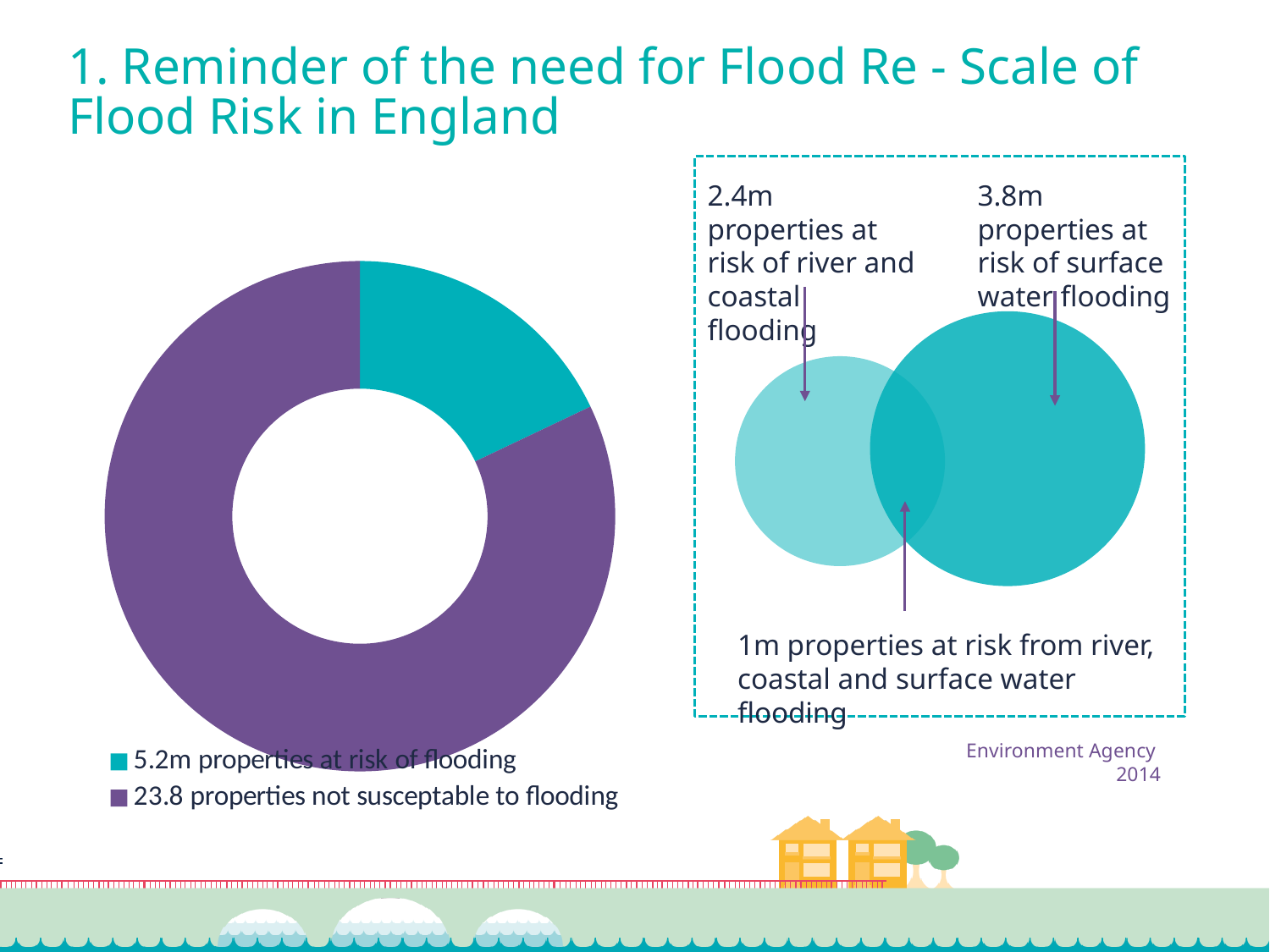
Which category takes the smaller share of the doughnut chart? 5.2m properties at risk of flooding In the overlapping-circles diagram on the right, how many properties are at risk of river and coastal flooding? 2.4m What kind of chart is shown on the left of the slide? doughnut chart In the doughnut chart, which colour represents properties not susceptable to flooding? purple In the overlapping-circles diagram on the right, how many properties are at risk of surface water flooding? 3.8m In the overlapping-circles diagram on the right, how many properties are at risk from river, coastal and surface water flooding? 1m In the doughnut chart, what value is given for properties not susceptable to flooding? 23.8 In the doughnut chart, which colour represents properties at risk of flooding? teal How many entries does the legend of the doughnut chart list? 2 How many categories does the doughnut chart on the left show? 2 Which category takes the larger share of the doughnut chart? 23.8 properties not susceptable to flooding In the doughnut chart, how many properties are at risk of flooding? 5.2m